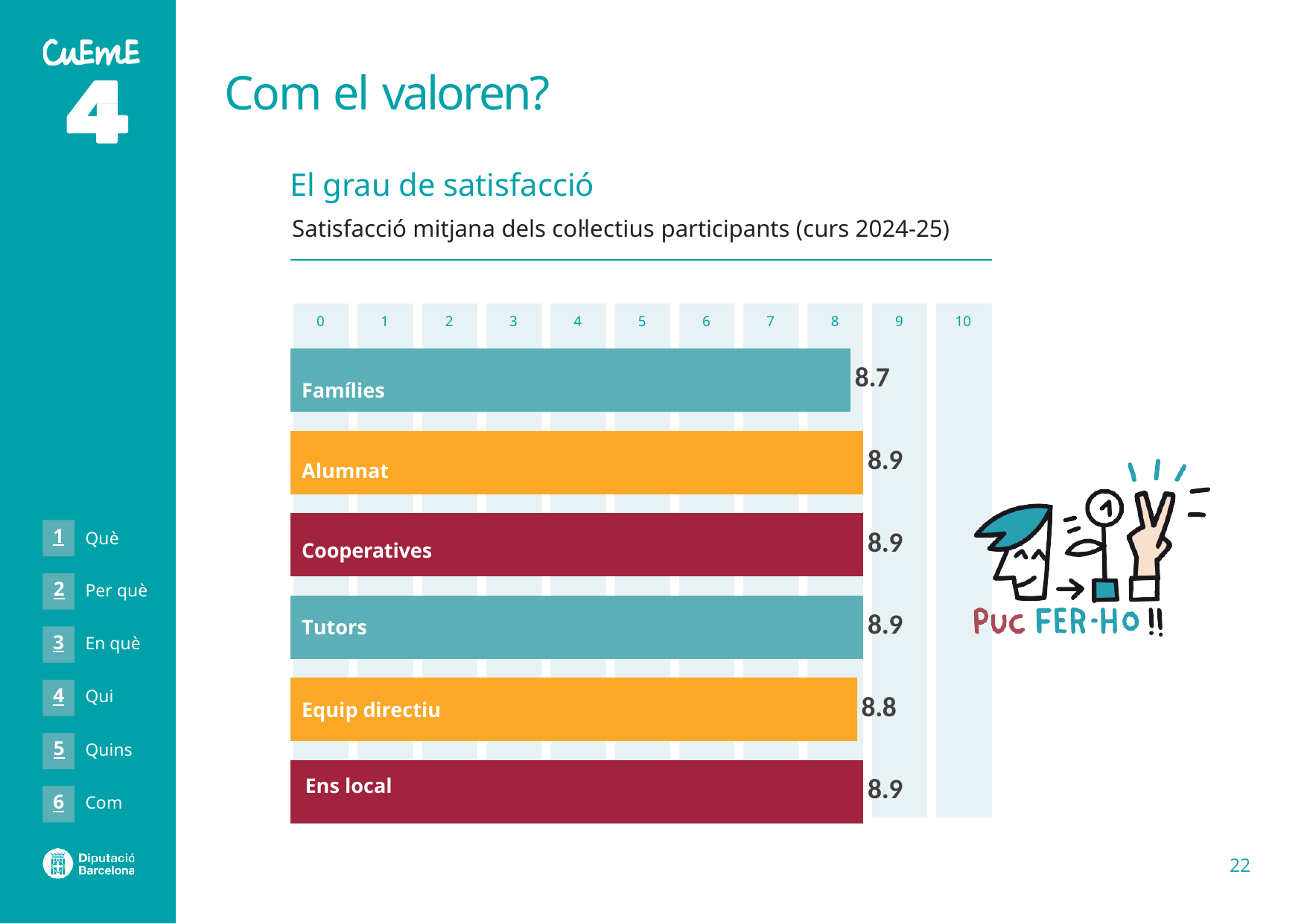
What is the satisfaction value for Alumnat? 8.9 What is the satisfaction value for Equip directiu? 8.8 How many groups are shown in the chart? 6 What is the difference between the values for Equip directiu and Famílies? 0.1 What is the satisfaction value for Famílies? 8.7 What is the difference between the values for Alumnat and Famílies? 0.2 What kind of chart is shown on the slide? Bar chart Is the value for Tutors greater or less than 8? greater Which group has the lowest satisfaction value? Famílies What is the subtitle describing the chart's data? Satisfacció mitjana dels col·lectius participants (curs 2024-25) What is the satisfaction value for Ens local? 8.9 Which is larger, the value for Equip directiu or the value for Famílies? Equip directiu